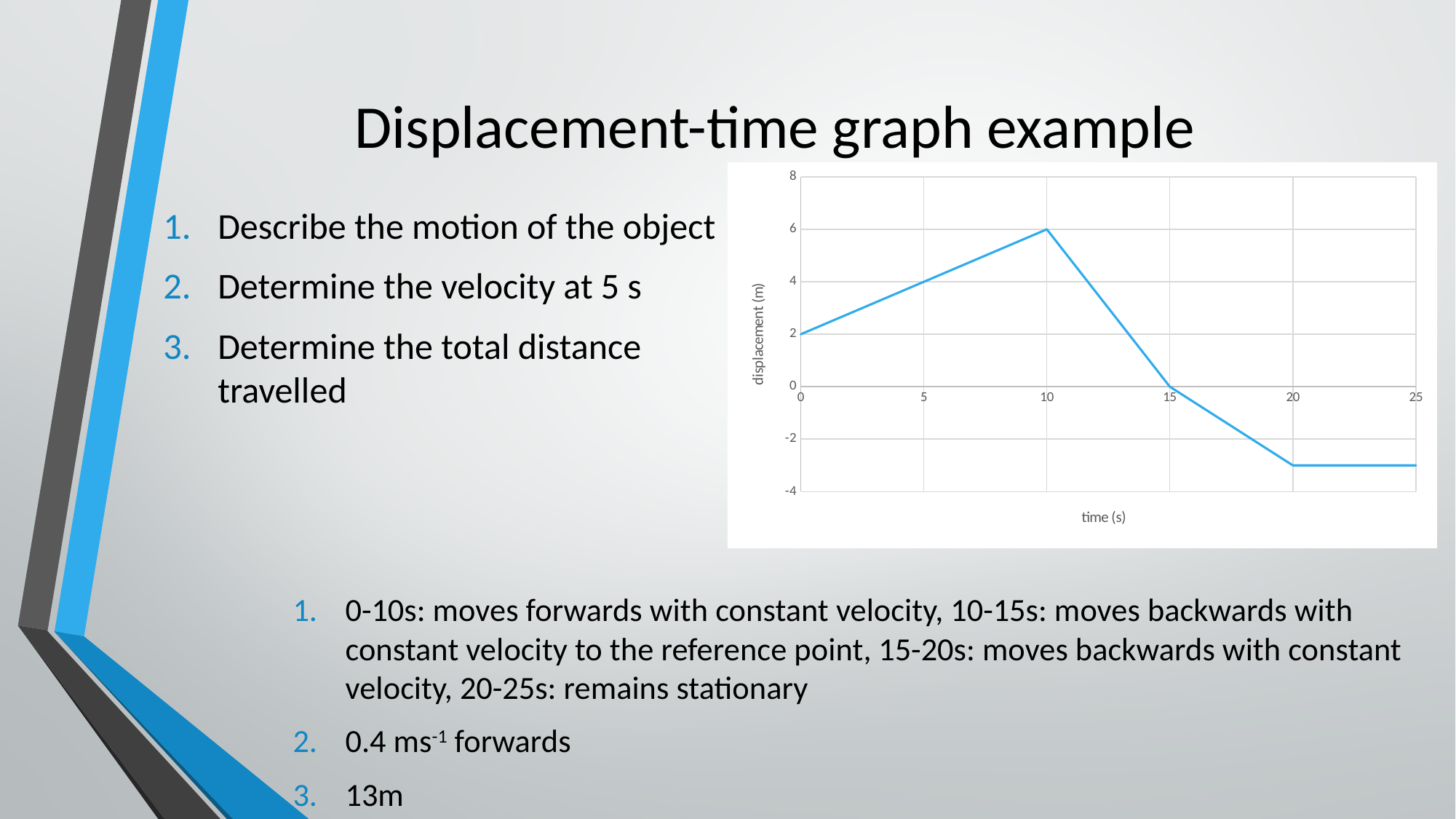
Is the displacement at 20 s greater or less than -2? less What is the displacement at time 10 s? 6 What is the difference between the displacement at 10 s and the displacement at 15 s? 6 What is the displacement at time 15 s? 0 What is the displacement at time 0 s? 2 What is the difference between the displacement at 10 s and the displacement at 0 s? 4 What is the label on the vertical axis of the chart? displacement (m) At what time does the displacement reach its highest value? 10 Is the displacement at 5 s greater or less than 2? greater Does the displacement rise or fall between 10 s and 20 s? fall What type of chart is shown on the slide? line chart Which is larger, the displacement at 0 s or the displacement at 15 s? 0 s